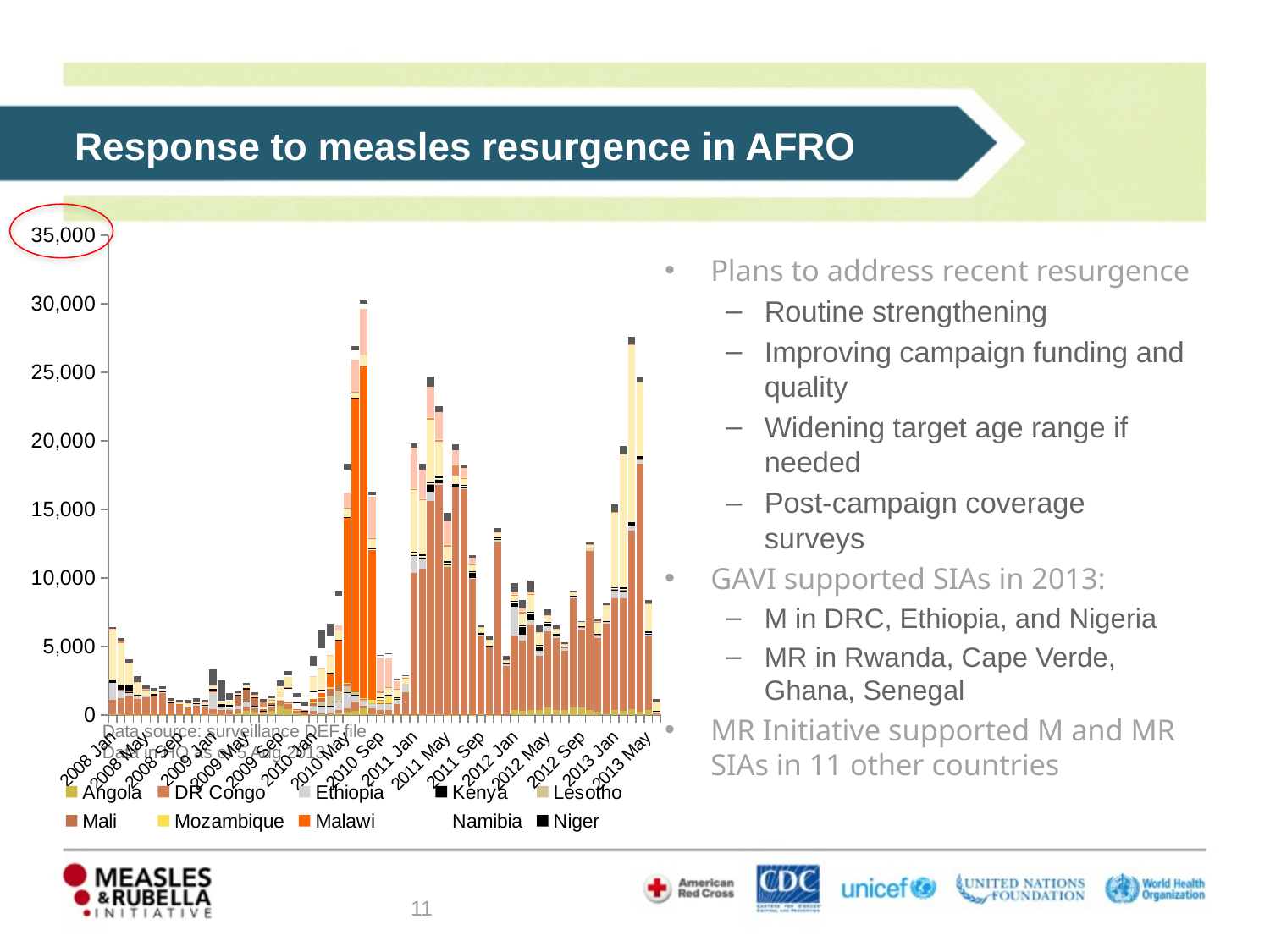
How many countries does the chart legend list? 10 What is the highest value shown on the chart's vertical axis? 35,000 Do the bar totals generally rise or fall from 2008 Jan to 2009 Jan? fall Which is larger, the bar for 2008 Jan or the bar for 2009 Jan? 2008 Jan Is the value for 2013 Jan greater or less than 30,000? less Which is larger, the bar for 2011 May or the bar for 2012 Jan? 2011 May Is the value for 2009 Jan greater or less than 5,000? less What kind of chart is shown on the slide? Stacked bar chart Is the tallest bar on the chart greater or less than 25,000? greater Which country is shown in bright orange in the chart legend? Malawi